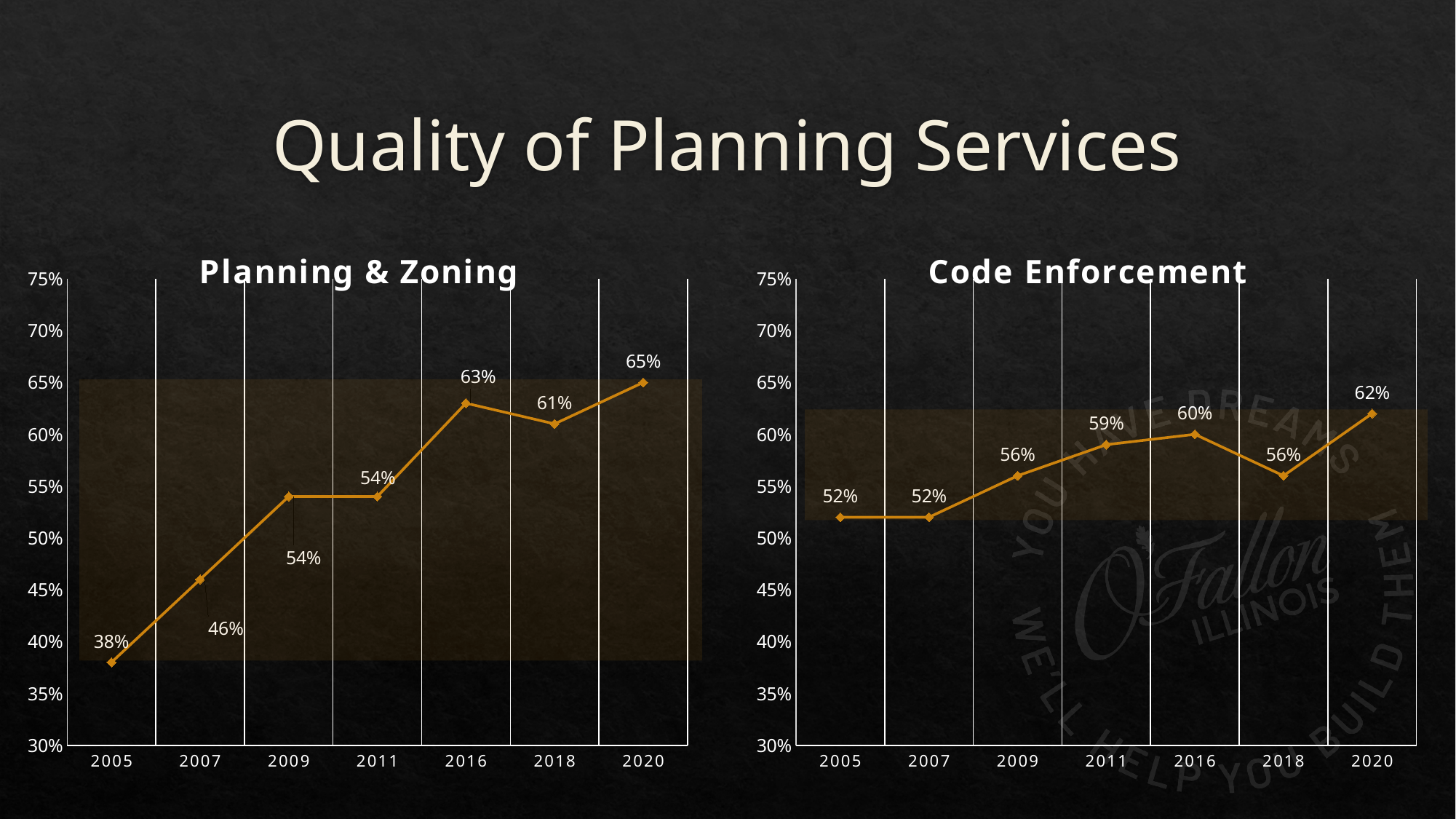
In the Code Enforcement chart, what is the value for 2016? 60% In the Planning & Zoning chart, which year has the highest value? 2020 How many data points are plotted in the Code Enforcement chart? 7 In the Code Enforcement chart, which year has the lowest value? 2005 and 2007 In the Planning & Zoning chart, which is larger, the value for 2016 or the value for 2018? 2016 In the Code Enforcement chart, what is the difference between the 2016 value and the 2018 value? 4% In the Code Enforcement chart, what is the value for 2020? 62% In the Planning & Zoning chart, do the values generally rise or fall from 2005 to 2020? Rise In the Planning & Zoning chart, what is the value for 2005? 38% What type of chart is the Planning & Zoning chart? Line chart In the Planning & Zoning chart, what is the difference between the 2020 value and the 2005 value? 27% In the Planning & Zoning chart, what is the value for 2018? 61%